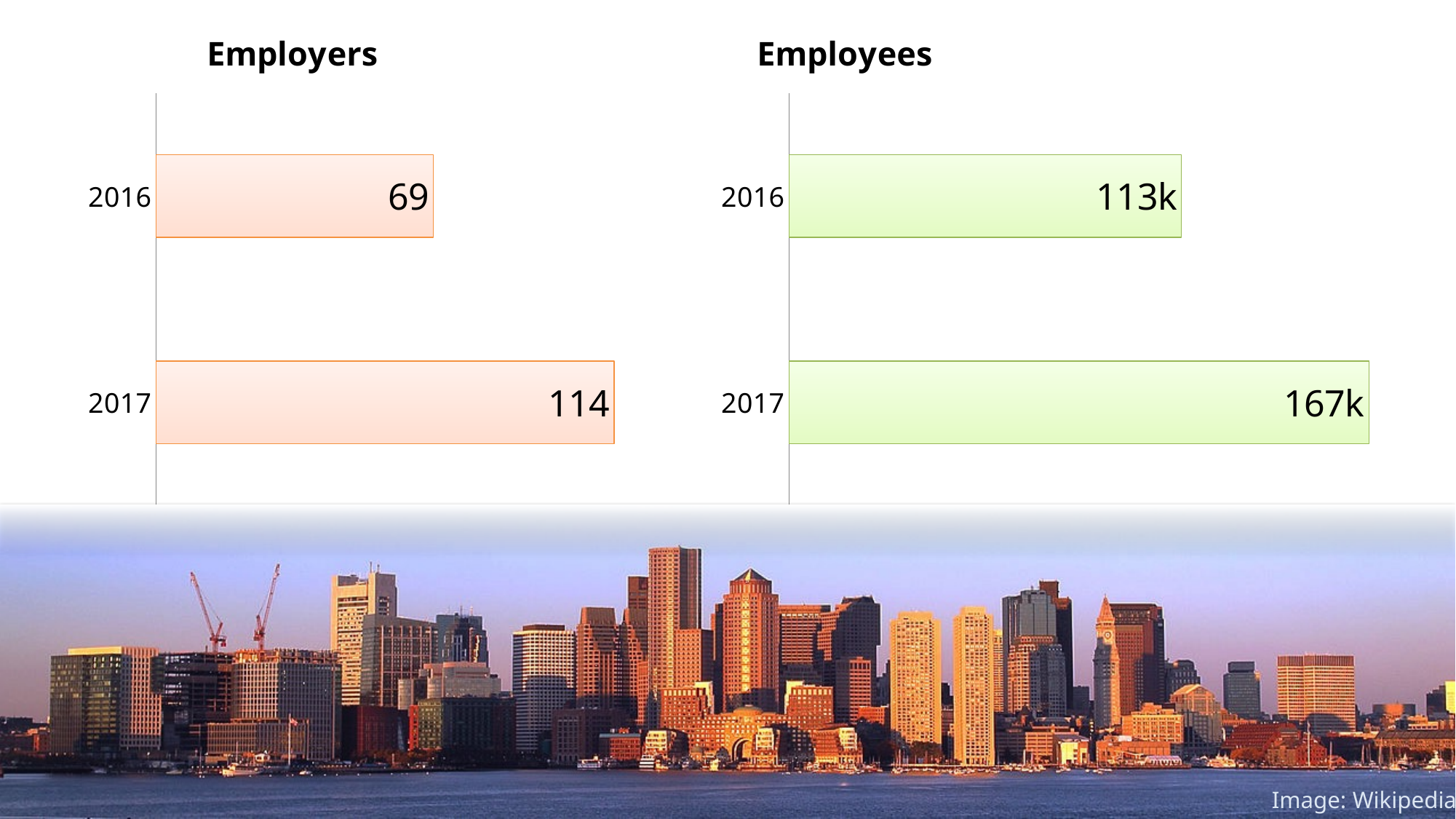
In the Employees chart, which year has the lower value? 2016 In the Employees chart, is the value for 2017 larger or smaller than the value for 2016? larger In the Employees chart, what is the value for 2017? 167k What colour are the bars in the Employees chart? green In the Employees chart, what is the difference between the 2017 and 2016 values? 54k In the Employers chart, what is the difference between the 2017 and 2016 values? 45 In the Employees chart, what is the value for 2016? 113k How many categories are shown in the Employers chart? 2 In the Employers chart, what is the value for 2017? 114 In the Employers chart, which year has the higher value? 2017 What kind of chart is the Employees chart? bar chart In the Employers chart, what is the value for 2016? 69